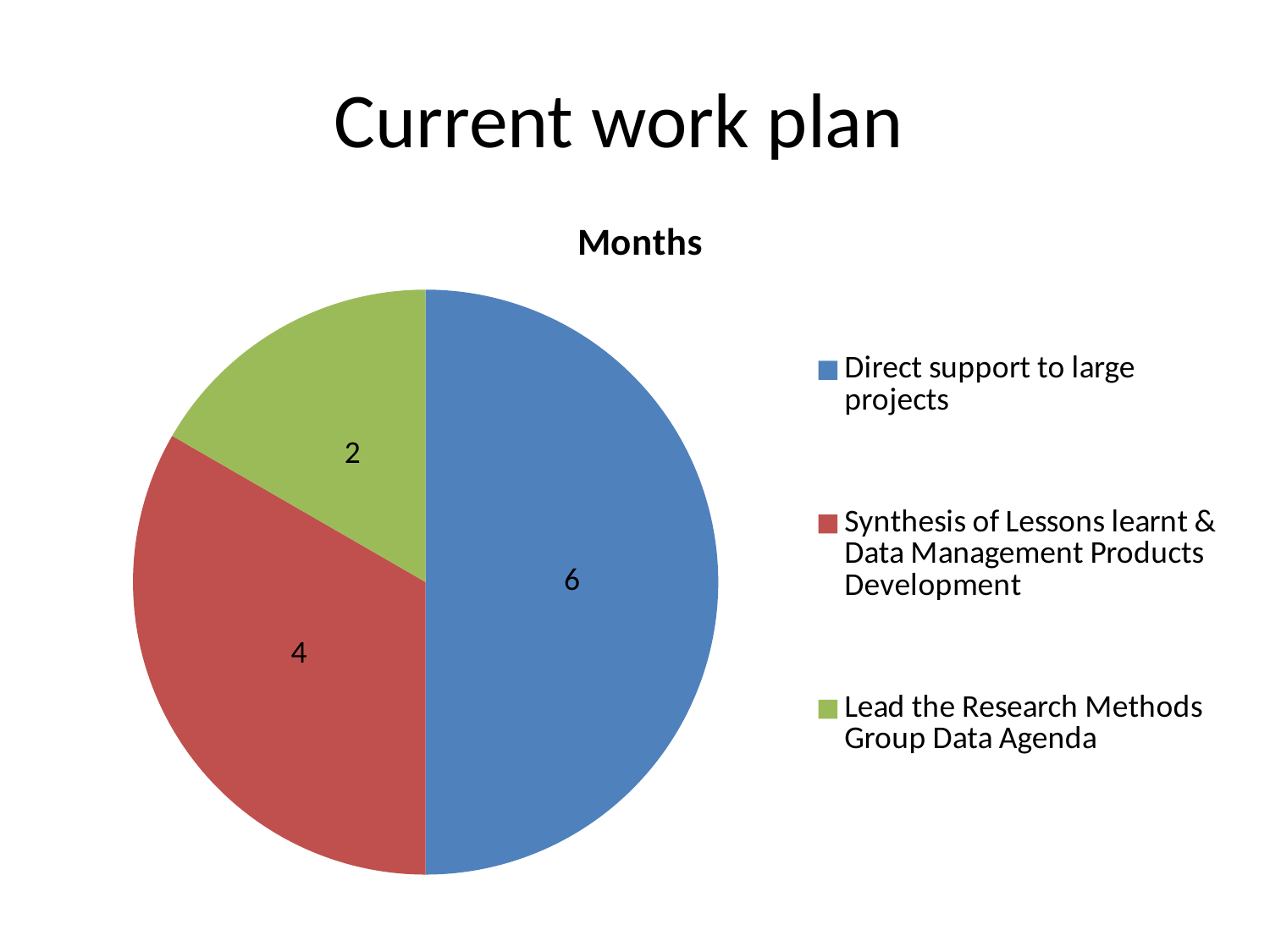
What type of chart is shown on the slide? pie chart How many months are allocated to Direct support to large projects? 6 How many slices does the pie chart have? 3 Which is larger: the value for Synthesis of Lessons learnt & Data Management Products Development or the value for Lead the Research Methods Group Data Agenda? Synthesis of Lessons learnt & Data Management Products Development Which category has the largest slice of the pie? Direct support to large projects How many months are allocated to Lead the Research Methods Group Data Agenda? 2 What is the chart's title? Months What share of the pie does Direct support to large projects represent? 50% What is the difference in months between Direct support to large projects and Lead the Research Methods Group Data Agenda? 4 How many months are allocated to Synthesis of Lessons learnt & Data Management Products Development? 4 Which category has the smallest slice of the pie? Lead the Research Methods Group Data Agenda What colour is the slice for Synthesis of Lessons learnt & Data Management Products Development? red